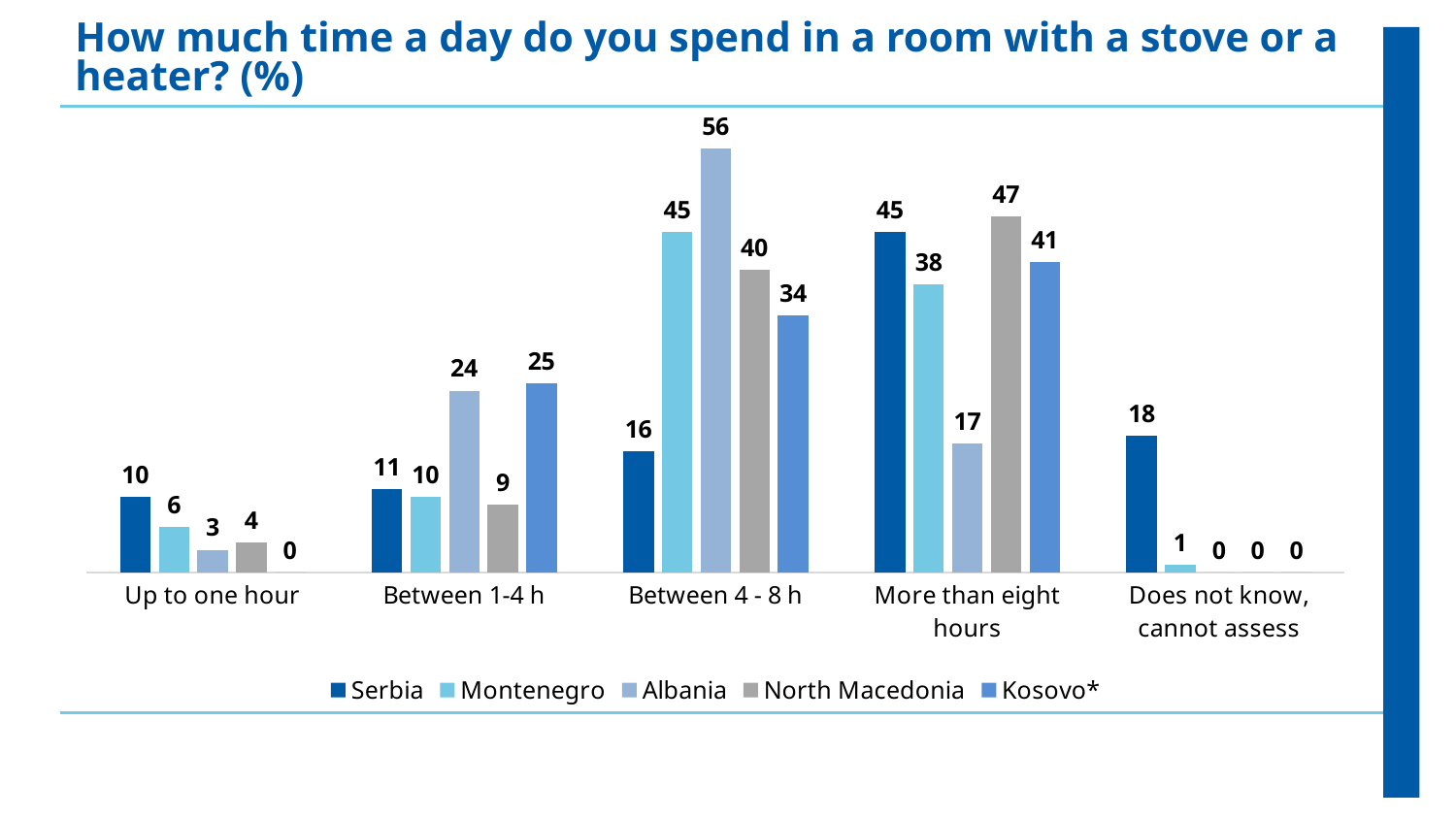
What is the difference between Albania and Kosovo* in the 'Between 4 - 8 h' category? 22 What is the value for North Macedonia in the 'More than eight hours' category? 47 Which is larger in the 'More than eight hours' category: Serbia or Montenegro? Serbia What is the value for Montenegro in the 'Between 1-4 h' category? 10 How many categories are shown on the x axis? 5 What is the title of the chart? How much time a day do you spend in a room with a stove or a heater? (%) Which country has the highest value in the 'Between 4 - 8 h' category? Albania How many series does the legend list? 5 What kind of chart is shown on the slide? Bar chart What is the value for Serbia in the 'Does not know, cannot assess' category? 18 Which country has the lowest value in the 'Up to one hour' category? Kosovo* What is the value for Albania in the 'Between 4 - 8 h' category? 56